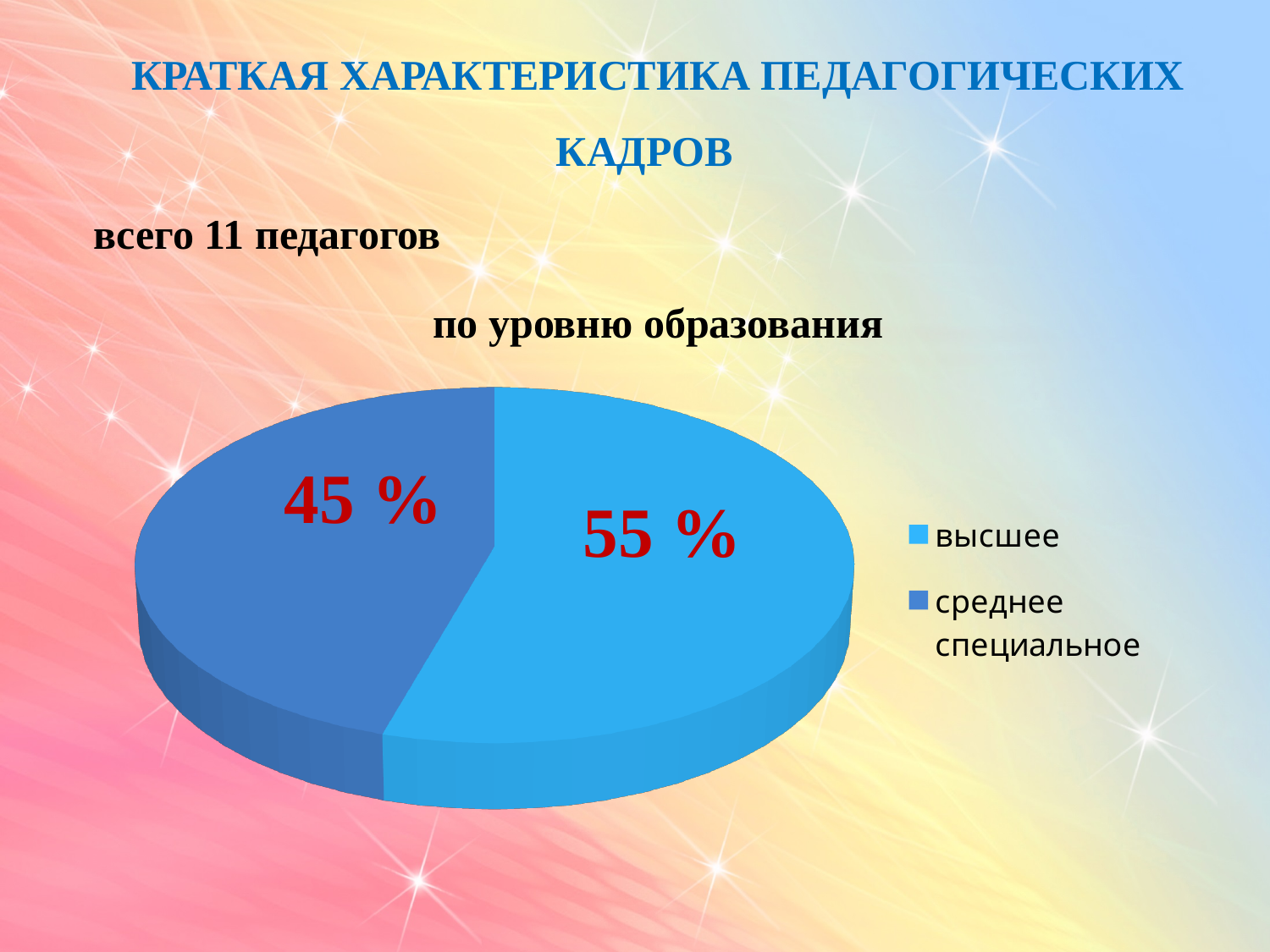
Which category has the smallest slice of the pie? среднее специальное What share of the pie does "высшее" have? 55 % How many entries does the legend list? 2 What is the difference between the shares of "высшее" and "среднее специальное"? 10 % What colour is the slice for "среднее специальное"? dark blue Is the share of "высшее" greater or less than 50%? greater What is the heading shown directly above the pie chart? по уровню образования What share of the pie does "среднее специальное" have? 45 % Which category has the largest slice of the pie? высшее How many slices does the pie chart have? 2 Which is larger: the share of "высшее" or the share of "среднее специальное"? высшее What kind of chart is shown on the slide? pie chart